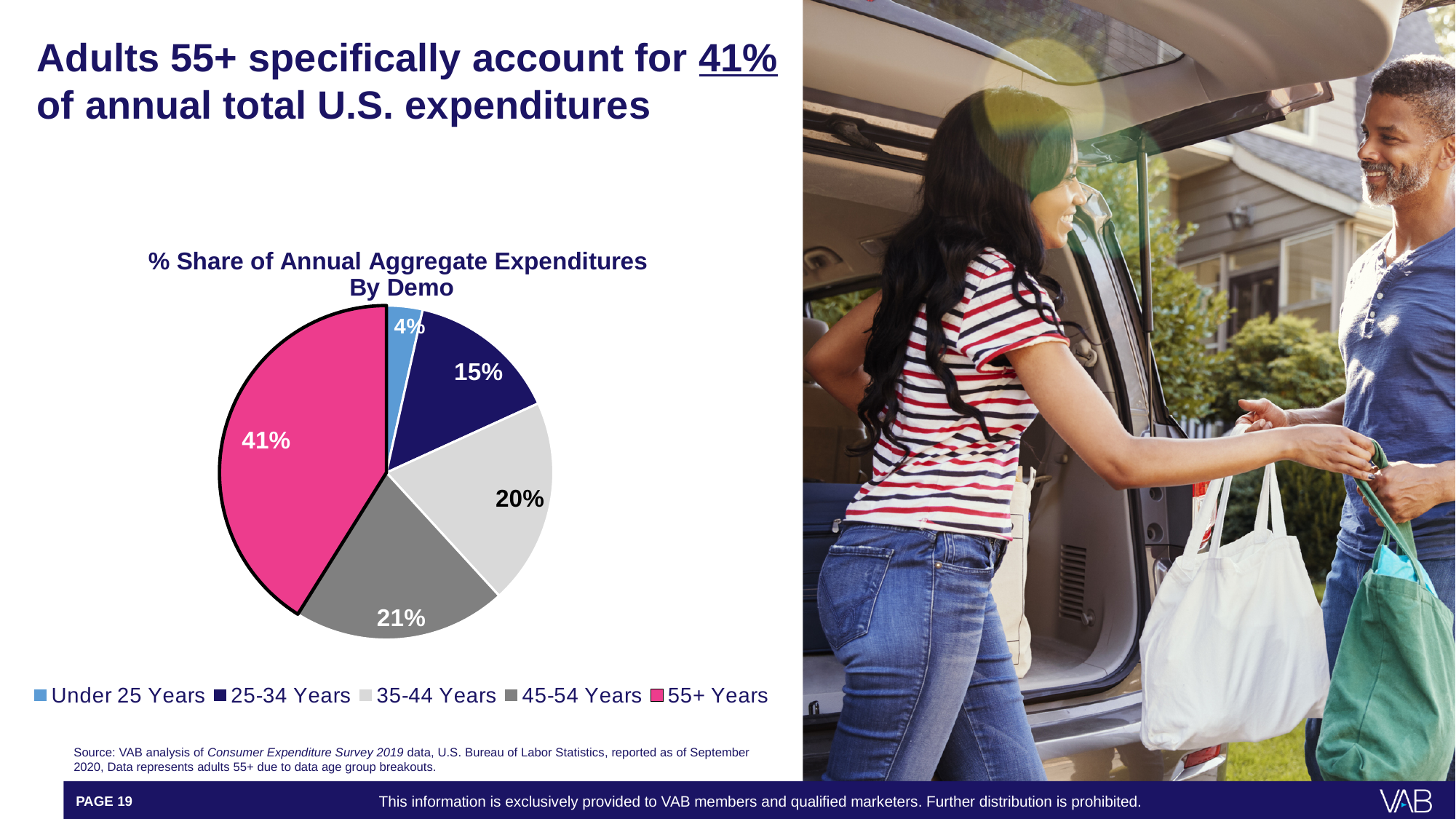
What share of annual aggregate expenditures is attributed to the 35-44 Years group? 20% Which group has a larger share of expenditures, 25-34 Years or 35-44 Years? 35-44 Years How many age groups are shown in the pie chart? 5 What is the title of the chart on the slide? % Share of Annual Aggregate Expenditures By Demo What share of annual aggregate expenditures is attributed to the 25-34 Years group? 15% Which age group accounts for the largest share of annual aggregate expenditures? 55+ Years What is the difference in share between the 55+ Years group and the 45-54 Years group? 20% What share of annual aggregate expenditures is attributed to adults 55+ Years? 41% What colour is the slice representing the 55+ Years group? Pink What share of annual aggregate expenditures is attributed to the Under 25 Years group? 4% Which age group accounts for the smallest share of annual aggregate expenditures? Under 25 Years What type of chart is used to show the share of annual aggregate expenditures by demo? Pie chart